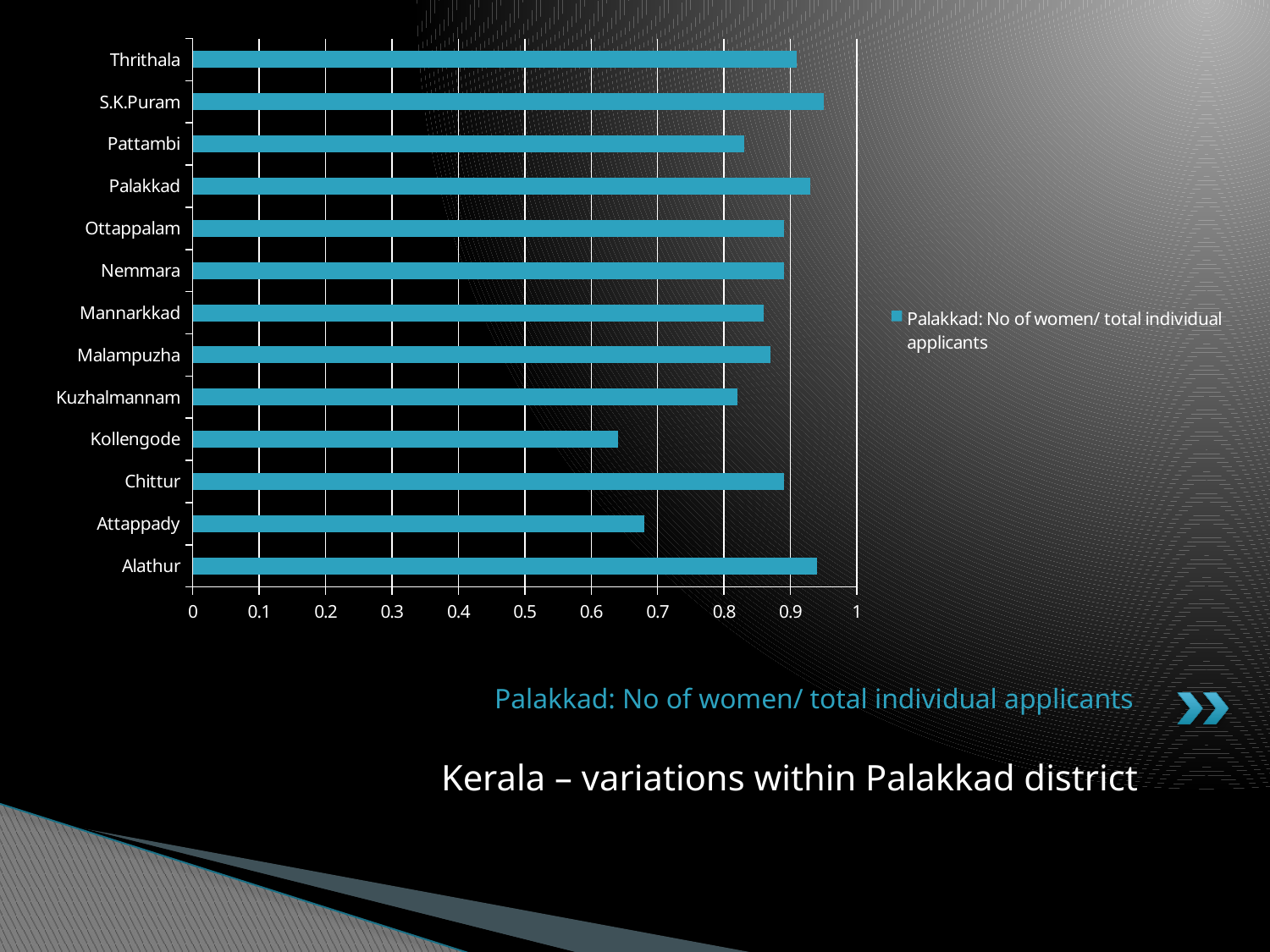
Is the value for Attappady greater or less than 0.7? less Is the value for Pattambi greater or less than 0.8? greater How many categories (blocks) are plotted on the chart? 13 Is the value for Kollengode greater or less than 0.7? less Which has the larger value, Pattambi or Kollengode? Pattambi What kind of chart is shown on the slide? bar chart How many series does the legend list? 1 Which category has the lowest value on the chart? Kollengode What is the series name shown in the chart legend? Palakkad: No of women/ total individual applicants Which has the larger value, Thrithala or Kuzhalmannam? Thrithala